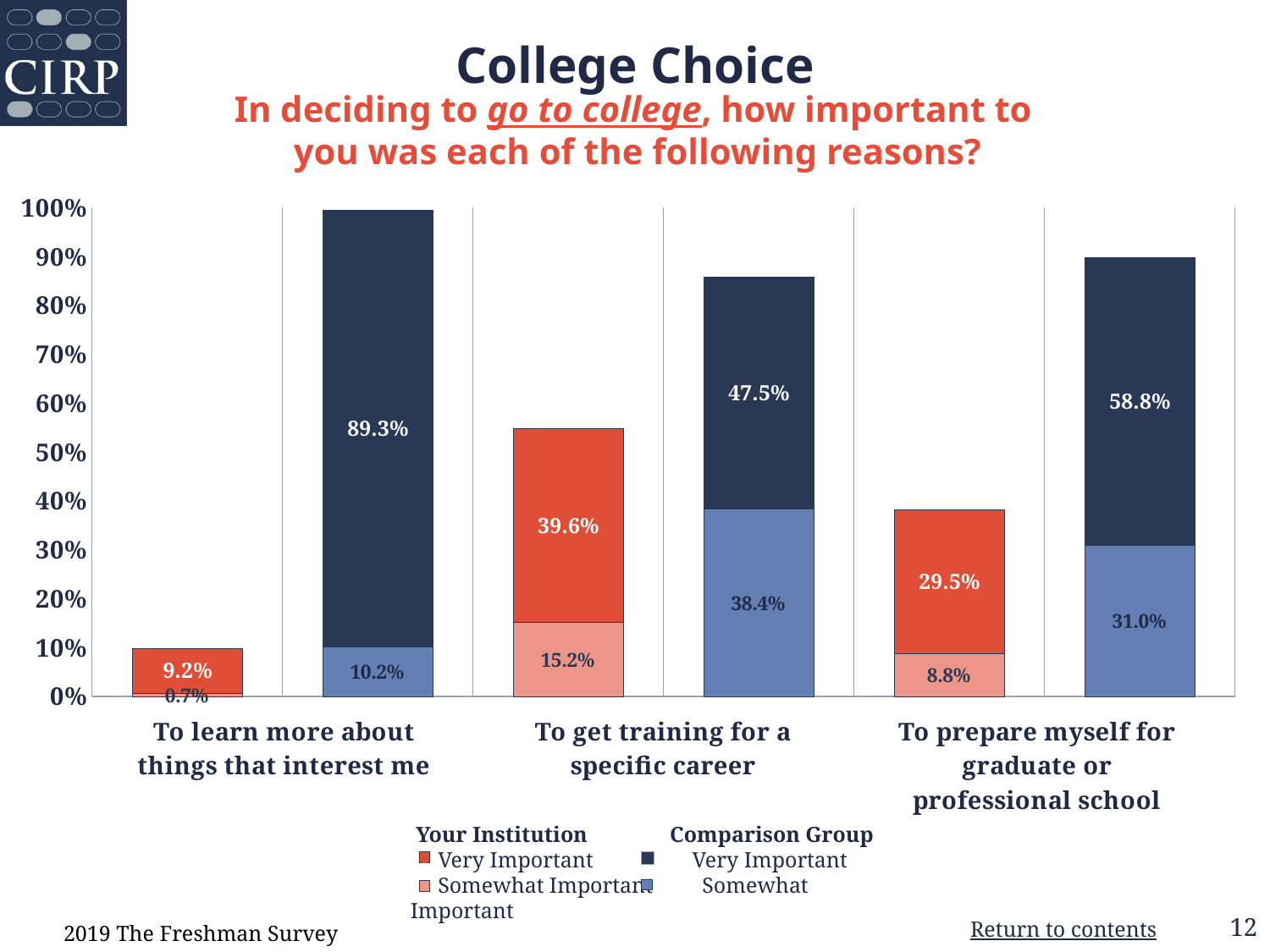
What is the combined Very Important and Somewhat Important percentage for the Comparison Group on "To prepare myself for graduate or professional school"? 89.8% Which reason has the highest Very Important percentage for the Comparison Group? To learn more about things that interest me Which reason has the lowest Very Important percentage for Your Institution? To learn more about things that interest me What percentage of the Comparison Group rated "To prepare myself for graduate or professional school" as Somewhat Important? 31.0% Which is larger: the Somewhat Important percentage for Your Institution or for the Comparison Group on "To get training for a specific career"? Comparison Group What is the combined Very Important and Somewhat Important percentage for Your Institution on "To get training for a specific career"? 54.8% What percentage of the Comparison Group rated "To learn more about things that interest me" as Very Important? 89.3% What percentage of Your Institution students rated "To get training for a specific career" as Very Important? 39.6% How many reasons (categories) are shown on the x axis? 3 What percentage of Your Institution students rated "To prepare myself for graduate or professional school" as Somewhat Important? 8.8% What kind of chart is shown on the slide? Stacked bar chart What is the difference between the Comparison Group and Your Institution Very Important percentages for "To get training for a specific career"? 7.9%